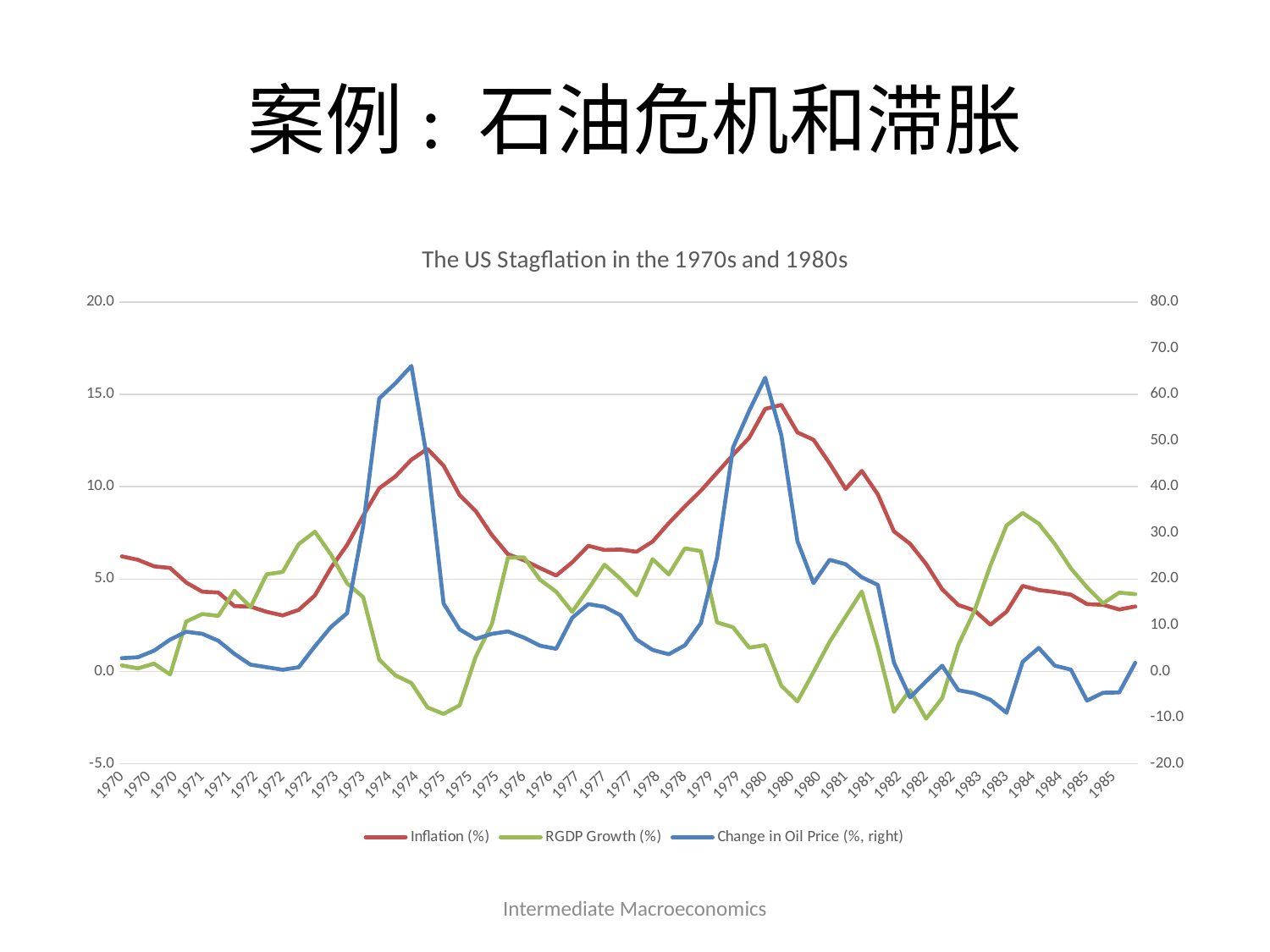
Around 1980, which series is higher on the left axis, Inflation (%) or RGDP Growth (%)? Inflation (%) Is the lowest RGDP Growth (%) value around 1982 greater or less than 0.0? less Does Inflation (%) rise or fall from 1980 to 1985? fall Is the peak of Change in Oil Price around 1974 greater or less than 60.0 on the right axis? greater Which series is plotted against the right-hand axis? Change in Oil Price (%, right) What kind of chart is shown on the slide? line chart Is the Inflation (%) value at the start of 1970 greater or less than 5.0? greater How many series does the legend list? 3 Does Inflation (%) rise or fall from 1976 to 1980? rise What is the title of the chart? The US Stagflation in the 1970s and 1980s